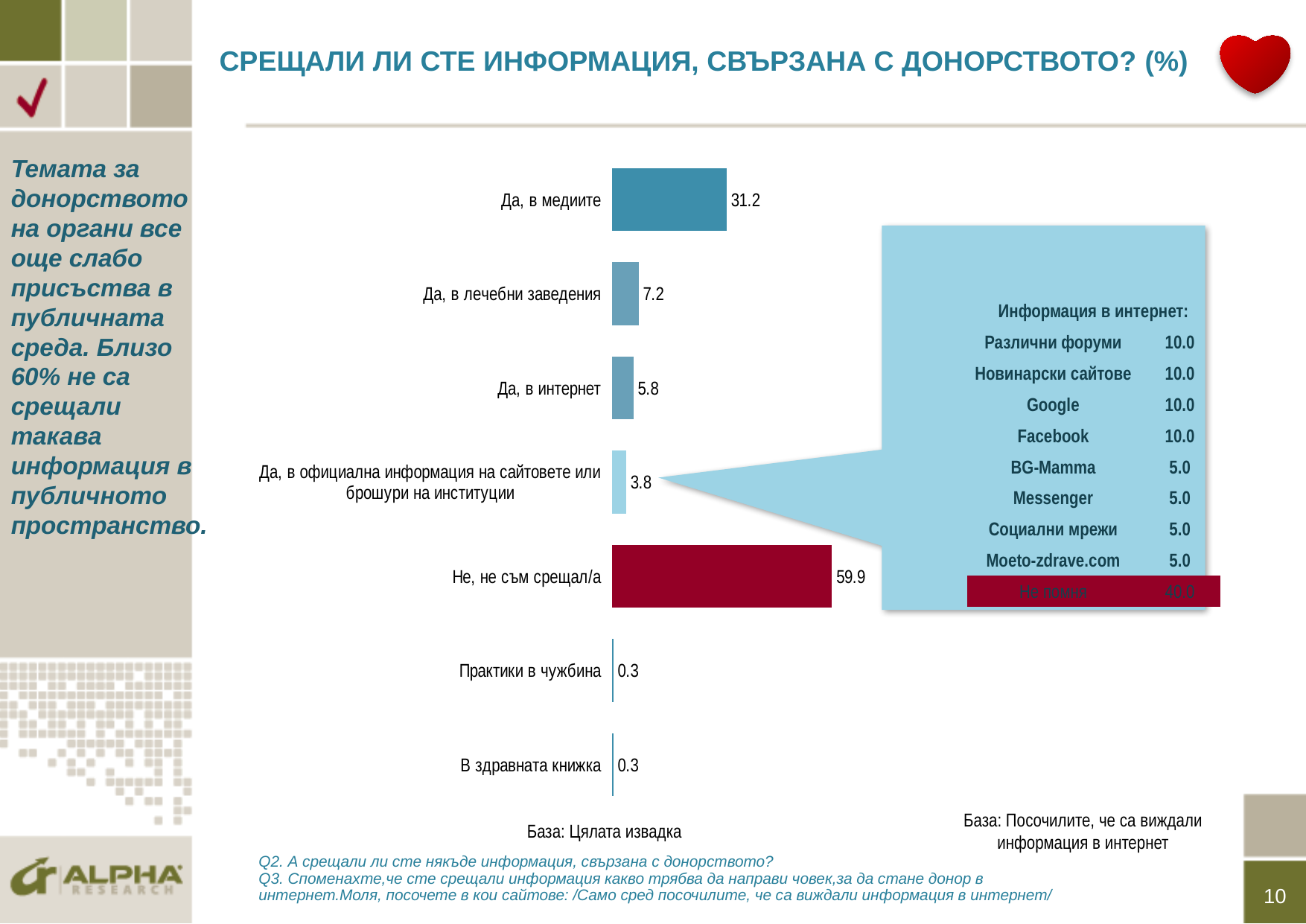
Which category has the highest value? Не, не съм срещал/а What is the difference between "Не, не съм срещал/а" and "Да, в медиите"? 28.7 What is the value for "Да, в интернет"? 5.8 What is the value for "Да, в лечебни заведения"? 7.2 What is the value for "Да, в медиите"? 31.2 How many categories are shown in the bar chart? 7 What is the value for "Практики в чужбина"? 0.3 Which is larger: "Да, в медиите" or "Да, в лечебни заведения"? Да, в медиите What kind of chart is shown on the slide? Bar chart What is the title of the chart? СРЕЩАЛИ ЛИ СТЕ ИНФОРМАЦИЯ, СВЪРЗАНА С ДОНОРСТВОТО? (%) What is the value for "Не, не съм срещал/а"? 59.9 What is the difference between "Да, в лечебни заведения" and "Да, в интернет"? 1.4